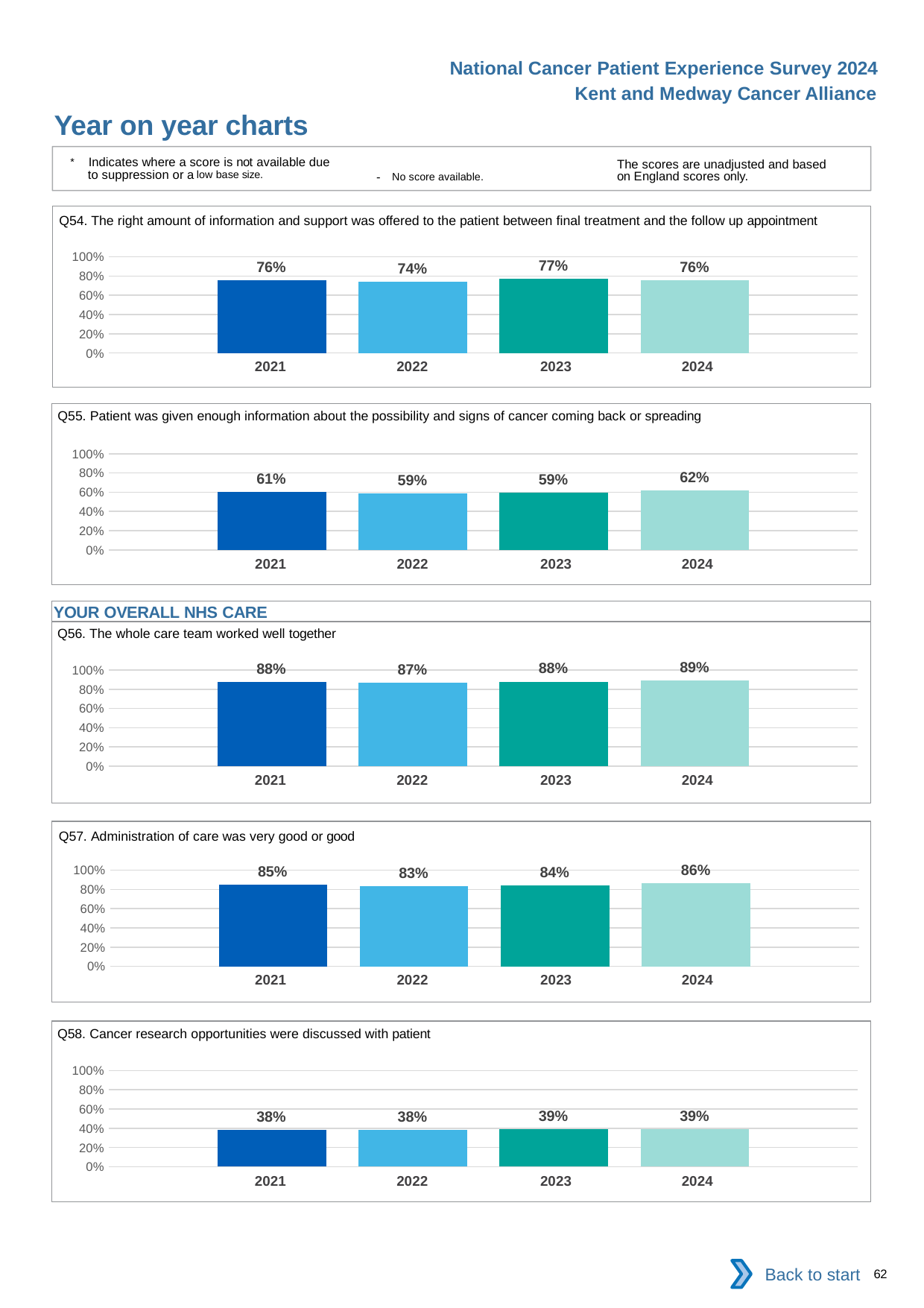
In the Q58 chart, what is the value for 2021? 38% What kind of chart is the Q55 chart? bar chart In the Q57 chart, what is the difference between the 2024 value and the 2022 value? 3% What is the section heading shown above the Q56 chart? YOUR OVERALL NHS CARE In the Q56 chart, which year has the lowest value? 2022 In the Q58 chart, is the value for 2024 greater or less than 60%? less In the Q55 chart, what is the difference between the 2024 value and the 2022 value? 3% In the Q54 chart, what is the value for 2023? 77% How many years are shown on the x axis of the Q54 chart? 4 In the Q55 chart, which year has the highest value? 2024 In the Q56 chart, what is the value for 2022? 87% In the Q57 chart, which is larger, the value for 2021 or the value for 2023? 2021